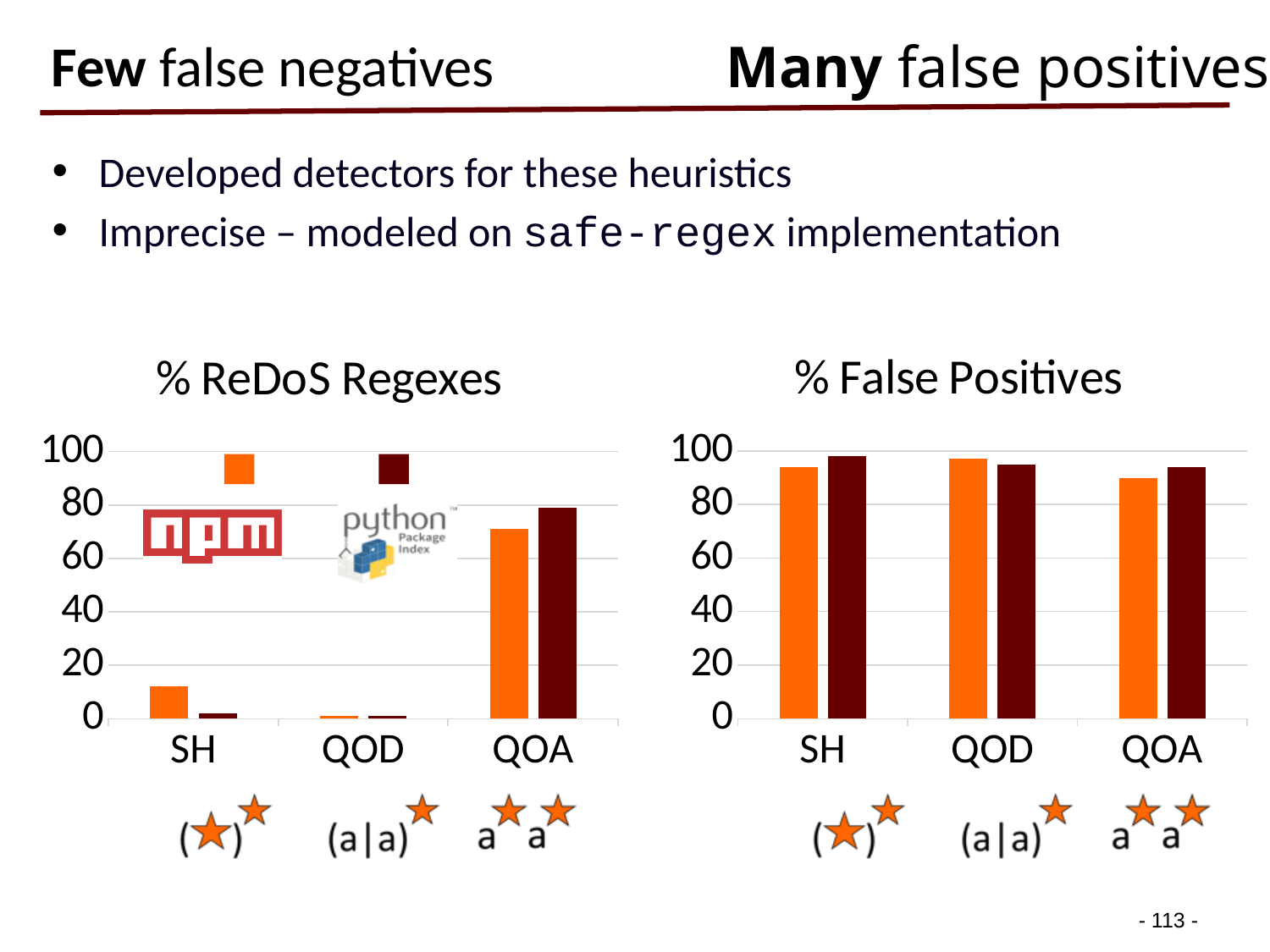
In the "% ReDoS Regexes" chart, which is larger for SH, the orange bar or the dark red bar? the orange bar In the "% ReDoS Regexes" chart, is the orange bar for SH greater or less than 20? less In the "% ReDoS Regexes" chart, is the orange bar for QOA greater or less than 60? greater In the "% False Positives" chart, is the orange bar for QOA greater or less than 80? greater In the "% ReDoS Regexes" chart, how many series (bar colours) are plotted per category? 2 In the "% ReDoS Regexes" chart, which is larger for QOA, the orange bar or the dark red bar? the dark red bar What is the title of the chart on the right side of the slide? % False Positives In the "% ReDoS Regexes" chart, which category has the highest values? QOA What kind of chart is the "% ReDoS Regexes" chart? bar chart What is the highest value shown on the y axis of the "% False Positives" chart? 100 How many categories are shown on the x axis of the "% False Positives" chart? 3